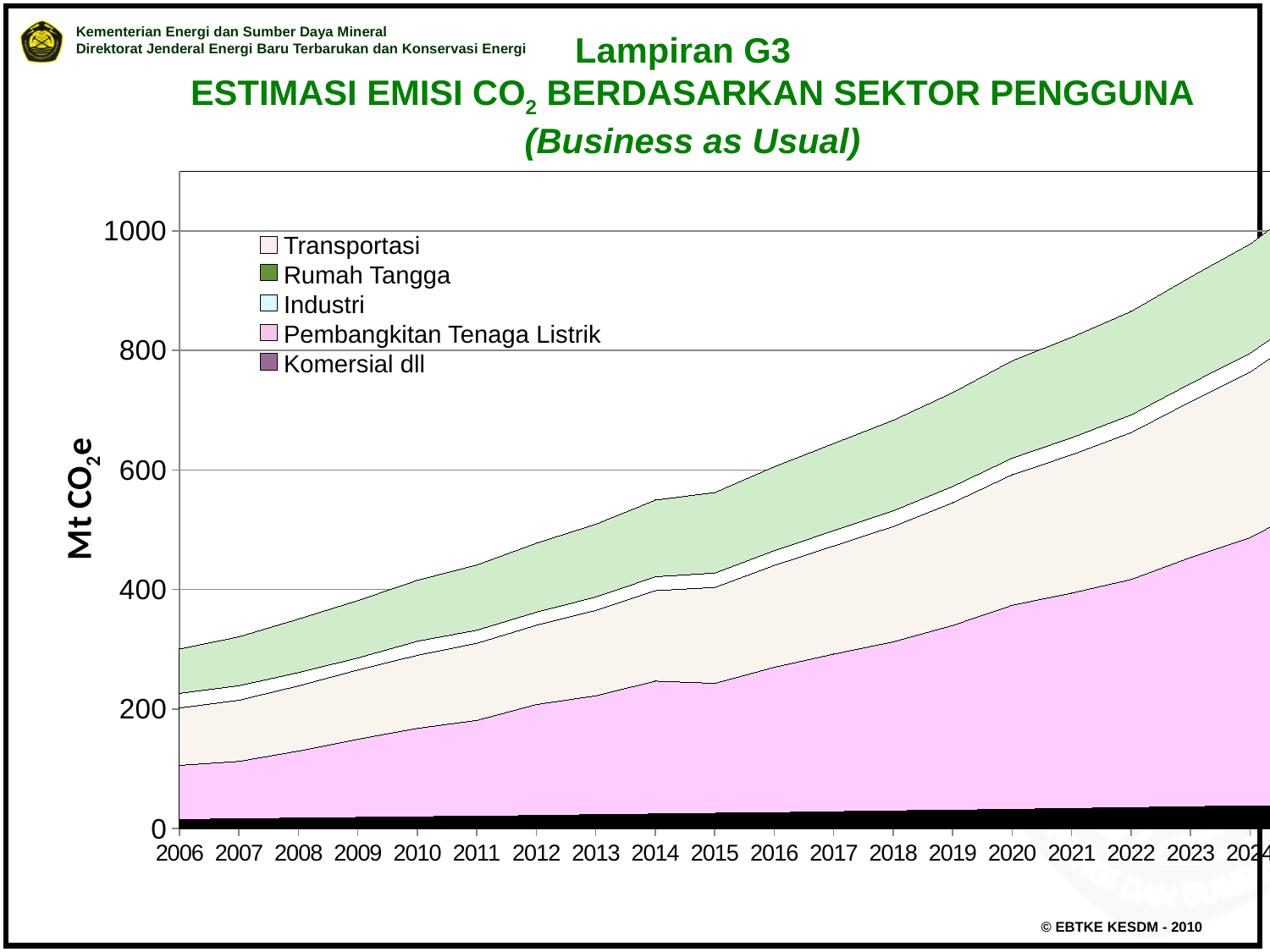
Which sector contributes the largest emissions in 2024? Pembangkitan Tenaga Listrik Is the total emission value for 2018 greater or less than 800 Mt CO2e? less Do total estimated CO2 emissions rise or fall from 2006 to 2024? Rise How many series does the legend list? 5 Is the total emission value for 2015 greater or less than 400 Mt CO2e? greater What is the label on the y axis? Mt CO2e What is the first year shown on the x axis? 2006 What kind of chart is shown on the slide? Stacked area chart Is the total emission value for 2006 greater or less than 400 Mt CO2e? less Which year has the higher total emissions, 2006 or 2024? 2024